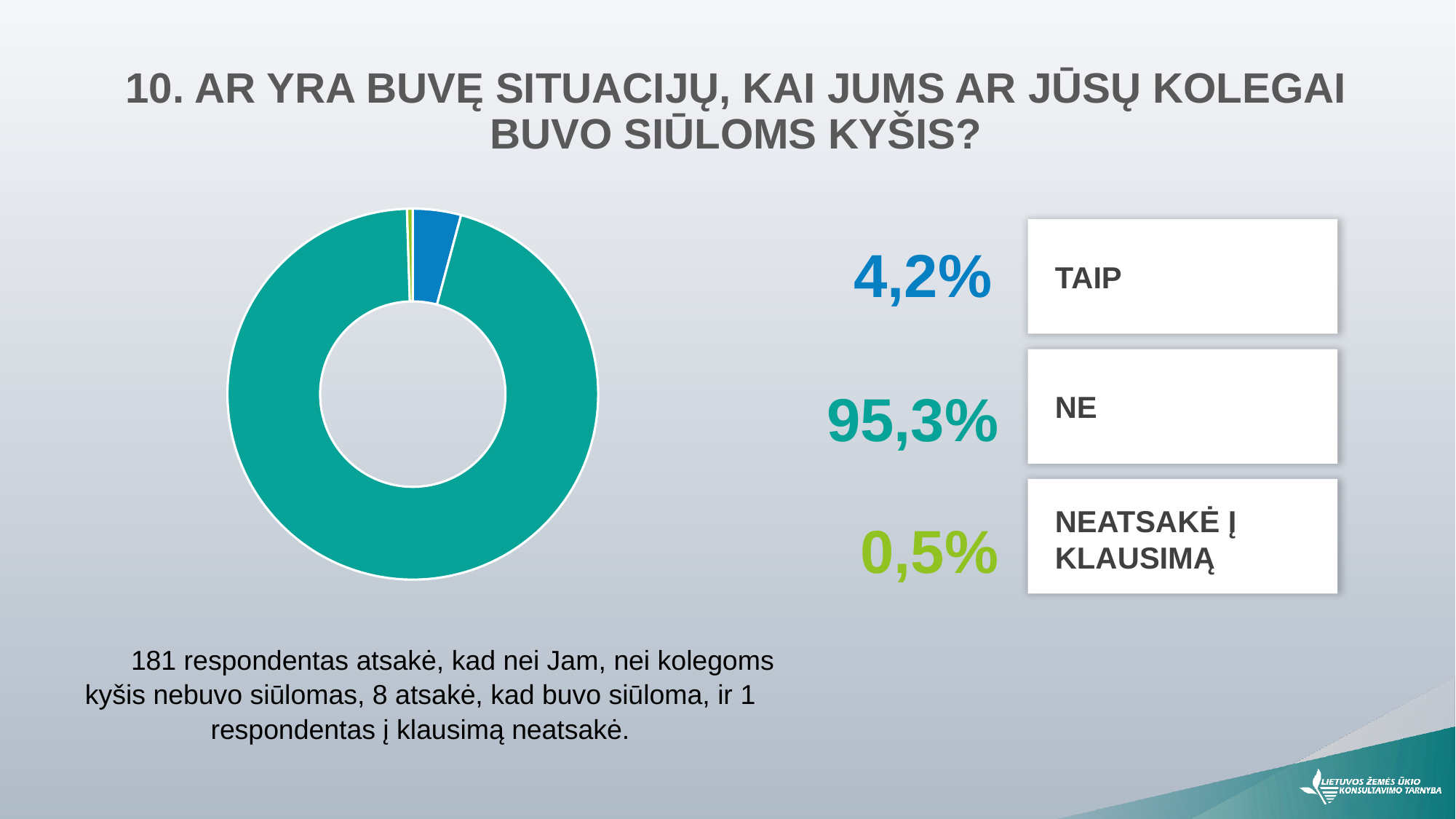
What kind of chart is shown on the slide? Pie chart (donut) Which is larger, the share for "TAIP" or the share for "NEATSAKĖ Į KLAUSIMĄ"? TAIP What is the difference in percentage points between the "NE" and "TAIP" shares? 91,1 What share of respondents answered "NE"? 95,3% How many answer categories does the chart show? 3 Which answer category has the largest share of the chart? NE What is the combined share of "TAIP" and "NEATSAKĖ Į KLAUSIMĄ"? 4,7% Which answer category has the smallest share of the chart? NEATSAKĖ Į KLAUSIMĄ What share of respondents answered "TAIP"? 4,2% What share of respondents is shown for "NEATSAKĖ Į KLAUSIMĄ"? 0,5% What colour is the slice representing "TAIP"? Blue What colour is the slice representing "NE"? Teal